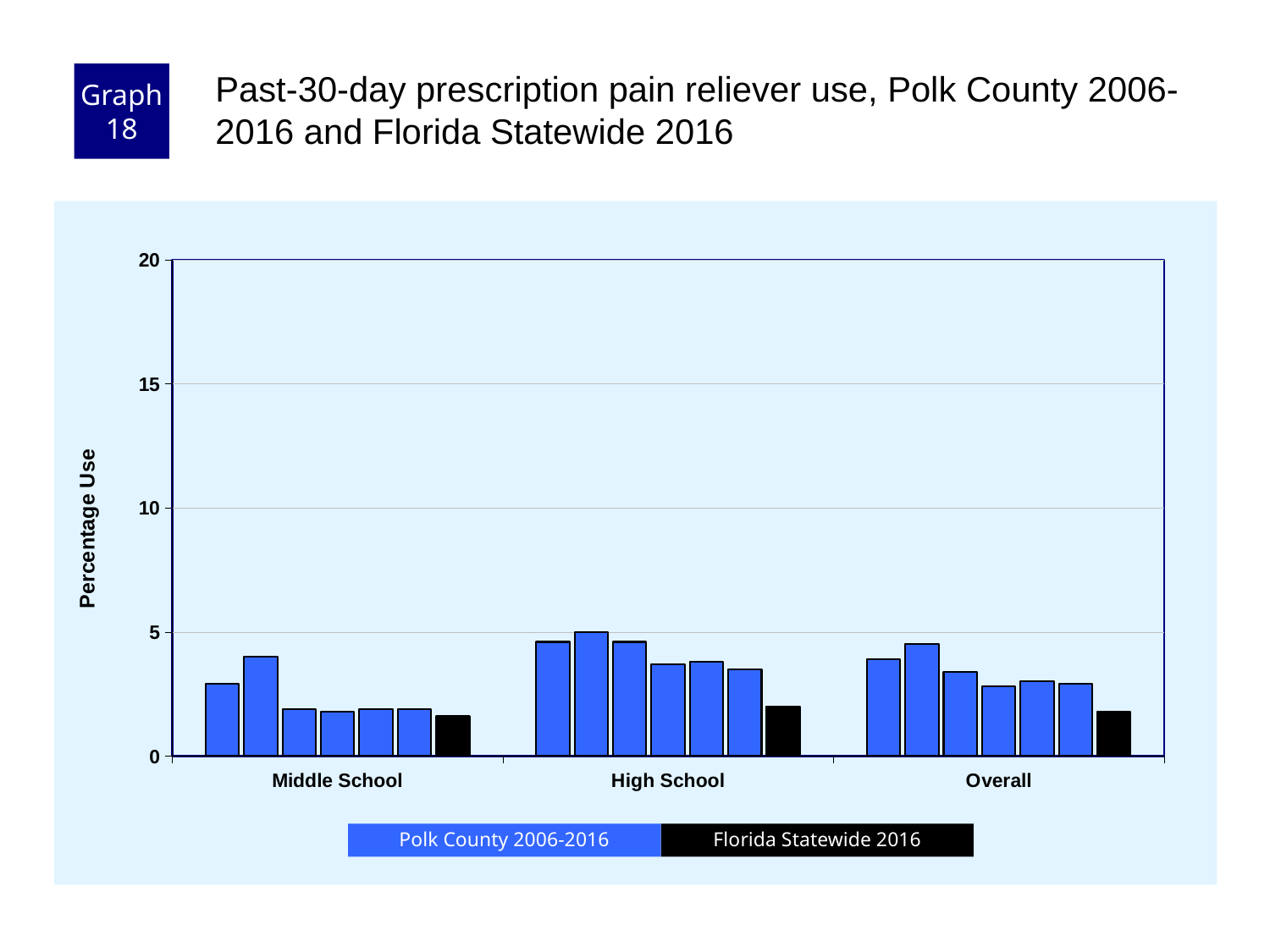
Which is larger: the Florida Statewide 2016 value for High School or for Middle School? High School Is the Florida Statewide 2016 value for Overall greater or less than 10? less Is the tallest bar in the Middle School group greater or less than 5? less What kind of chart is shown on the slide? bar chart Which x-axis category has the lowest bars overall? Middle School What colour represents Florida Statewide 2016 in the legend? black Is the Florida Statewide 2016 value for Middle School greater or less than 5? less What is the label on the y axis of the chart? Percentage Use How many series does the legend list? 2 How many categories are shown on the x axis of the chart? 3 Which x-axis category has the tallest bars overall? High School